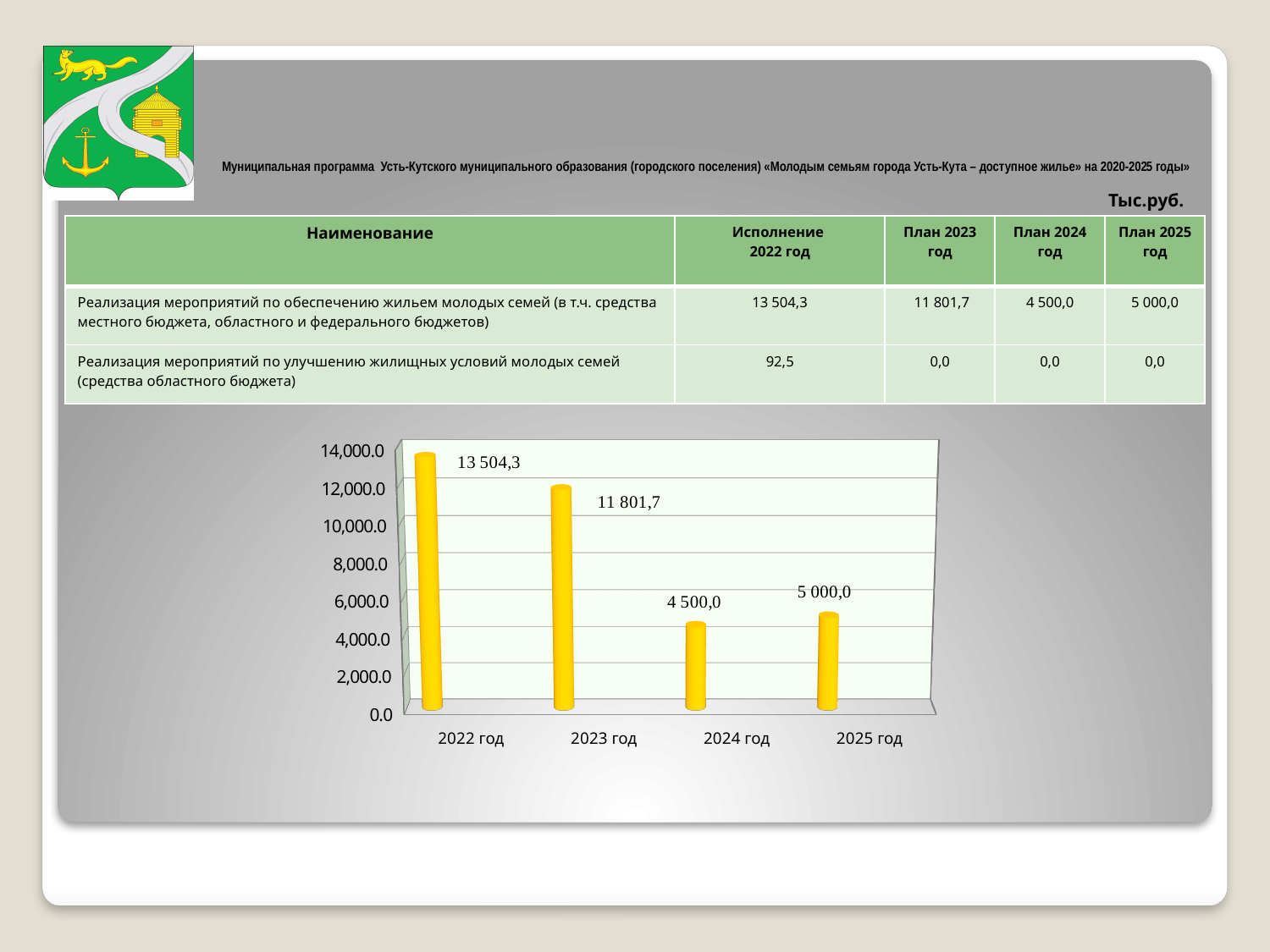
Do the values rise or fall from 2022 год to 2024 год? Fall How many bars are plotted on the chart? 4 What is the value shown for 2024 год on the chart? 4 500,0 What is the value shown for 2025 год on the chart? 5 000,0 What is the value shown for 2023 год on the chart? 11 801,7 What is the difference between the values for 2022 год and 2023 год? 1 702,6 What is the difference between the values for 2025 год and 2024 год? 500,0 What is the value shown for 2022 год on the chart? 13 504,3 What kind of chart is shown on the slide? Bar chart Which year has the highest value on the chart? 2022 год Which year has the lowest value on the chart? 2024 год Which is larger, the value for 2024 год or the value for 2025 год? 2025 год